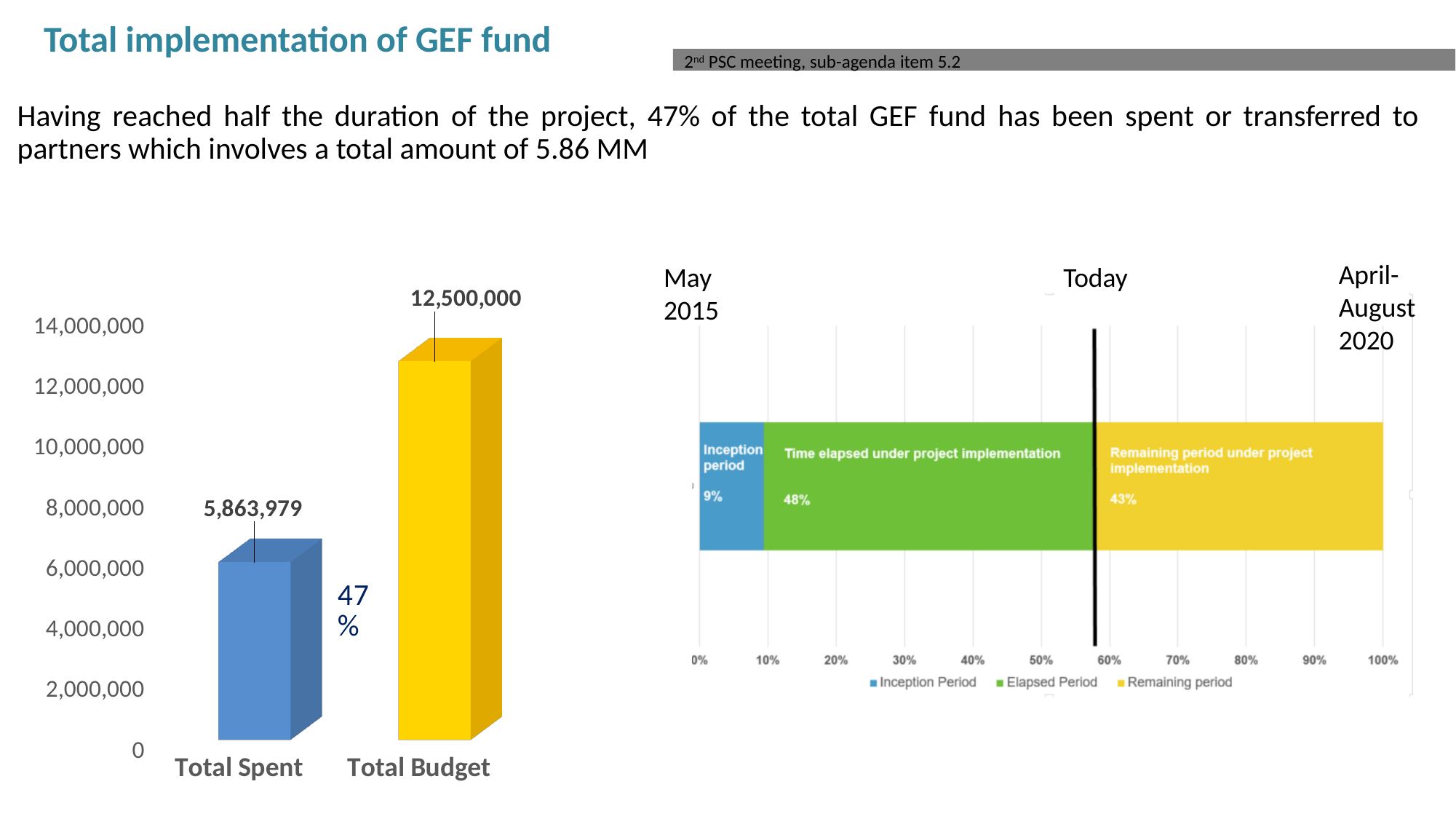
In the stacked bar chart on the right, what is the value for Time elapsed under project implementation? 48% In the bar chart on the left, what is the value for Total Budget? 12,500,000 In the bar chart on the left, how many bars are plotted? 2 In the stacked bar chart on the right, what is the value for the Inception period? 9% In the bar chart on the left, what is the value for Total Spent? 5,863,979 In the stacked bar chart on the right, which segment is the smallest? Inception period In the bar chart on the left, what is the difference between Total Budget and Total Spent? 6,636,021 In the bar chart on the left, what percentage label is shown next to the Total Spent bar? 47% In the stacked bar chart on the right, what is the value for Remaining period under project implementation? 43% In the stacked bar chart on the right, how many series does the legend list? 3 In the bar chart on the left, which category has the higher value? Total Budget What kind of chart is shown on the left of the slide? Bar chart